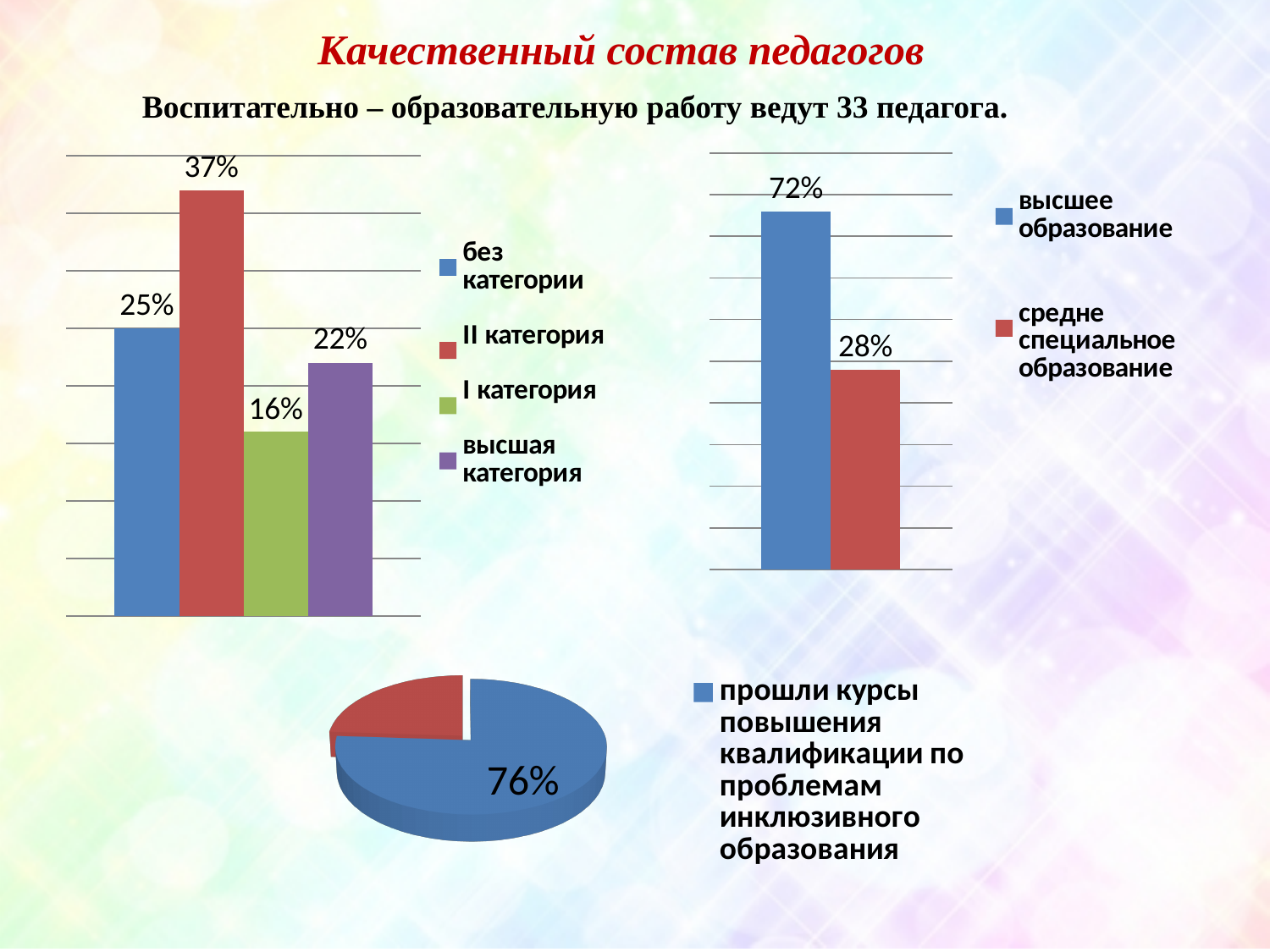
In the top-right bar chart, what is the difference between 'высшее образование' and 'средне специальное образование'? 44% In the top-left bar chart, what is the difference between 'II категория' and 'высшая категория'? 15% In the bottom pie chart, what share is labelled for 'прошли курсы повышения квалификации по проблемам инклюзивного образования'? 76% In the top-left bar chart, how many entries does the legend list? 4 In the top-left bar chart, what is the value for 'без категории'? 25% In the top-right bar chart, what is the value for 'средне специальное образование'? 28% In the top-right bar chart, what is the value for 'высшее образование'? 72% In the top-right bar chart, which is larger: 'высшее образование' or 'средне специальное образование'? высшее образование What kind of chart is the bottom chart on the slide? Pie chart In the top-left bar chart, what is the value for 'II категория'? 37% In the top-left bar chart, which category has the lowest value? I категория In the top-left bar chart, which category has the highest value? II категория